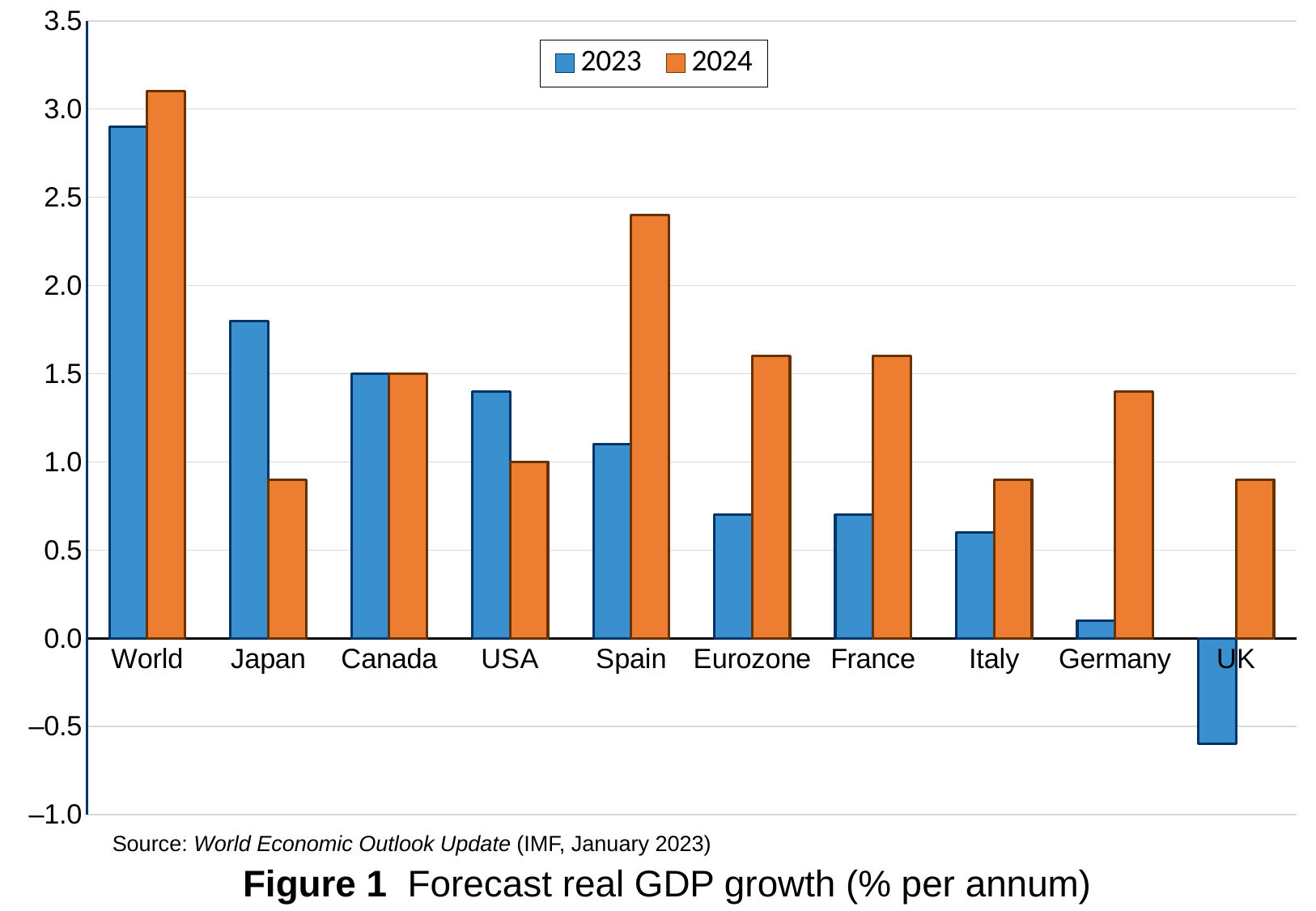
What kind of chart is shown on the slide? bar chart Is the 2024 value for Spain greater or less than 2.0? greater What is the source cited below the chart? World Economic Outlook Update (IMF, January 2023) Which category has the highest 2024 forecast? World For Japan, which is larger: the 2023 value or the 2024 value? 2023 Which category has the lowest 2023 forecast? UK For Germany, which is larger: the 2023 value or the 2024 value? 2024 How many countries or regions are shown on the x axis? 10 Is the 2023 value for Germany greater or less than 0.5? less How many series does the legend list? 2 Is the 2023 value for the UK greater or less than 0.0? less